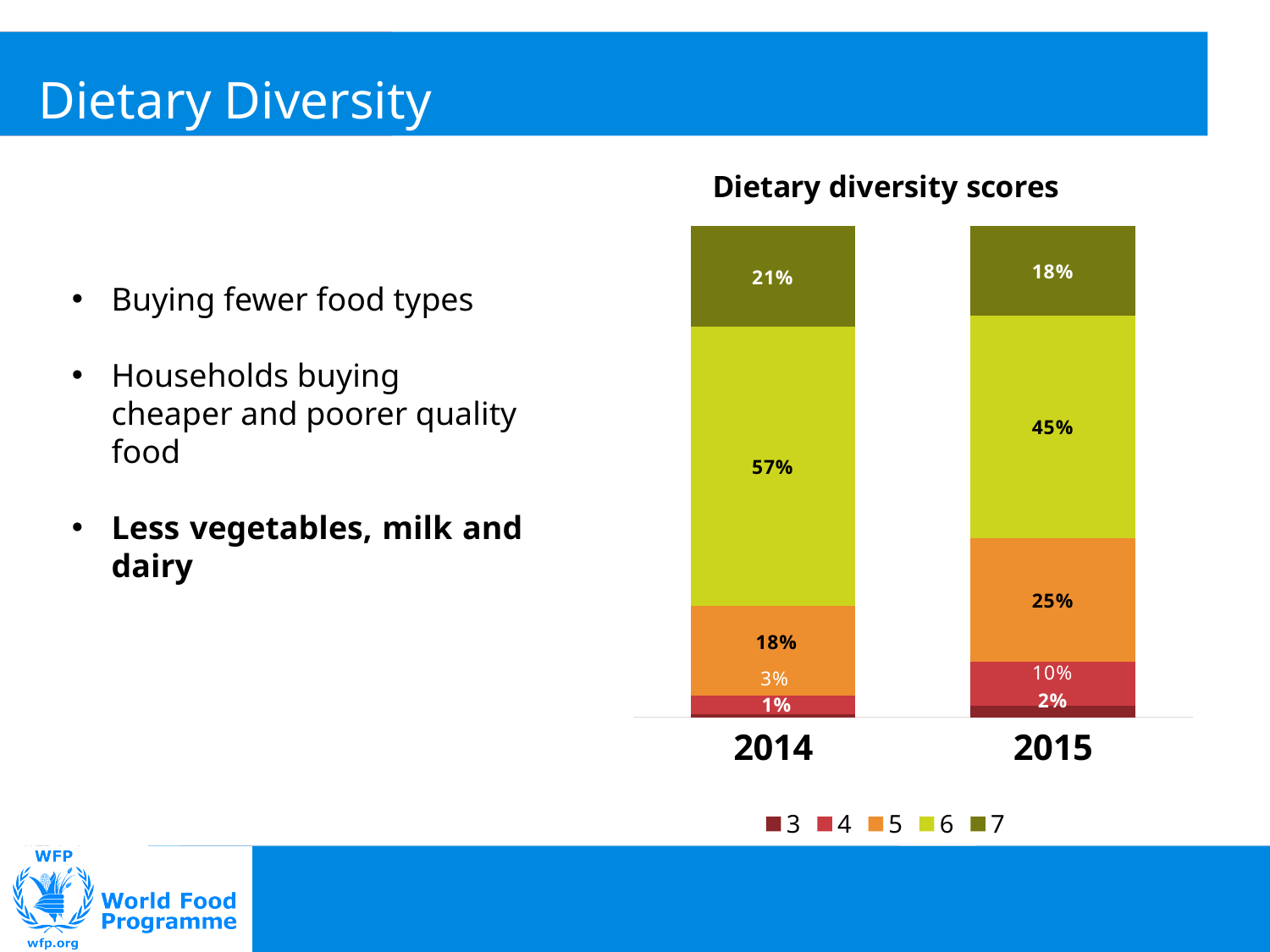
By how many percentage points did the share for score 6 fall from 2014 to 2015? 12 percentage points How many series does the legend list? 5 How many years (categories) are shown on the x axis? 2 What share of households had a dietary diversity score of 6 in 2015? 45% Which score category has the largest share in 2015? 6 What is the value for score 7 in 2014? 21% What is the value for score 5 in 2015? 25% Which score category has the smallest share in 2014? 3 Is the share for score 5 larger in 2014 or in 2015? 2015 What is the title of the chart? Dietary diversity scores What share of households had a dietary diversity score of 6 in 2014? 57% What type of chart is shown under the title 'Dietary diversity scores'? Stacked bar chart